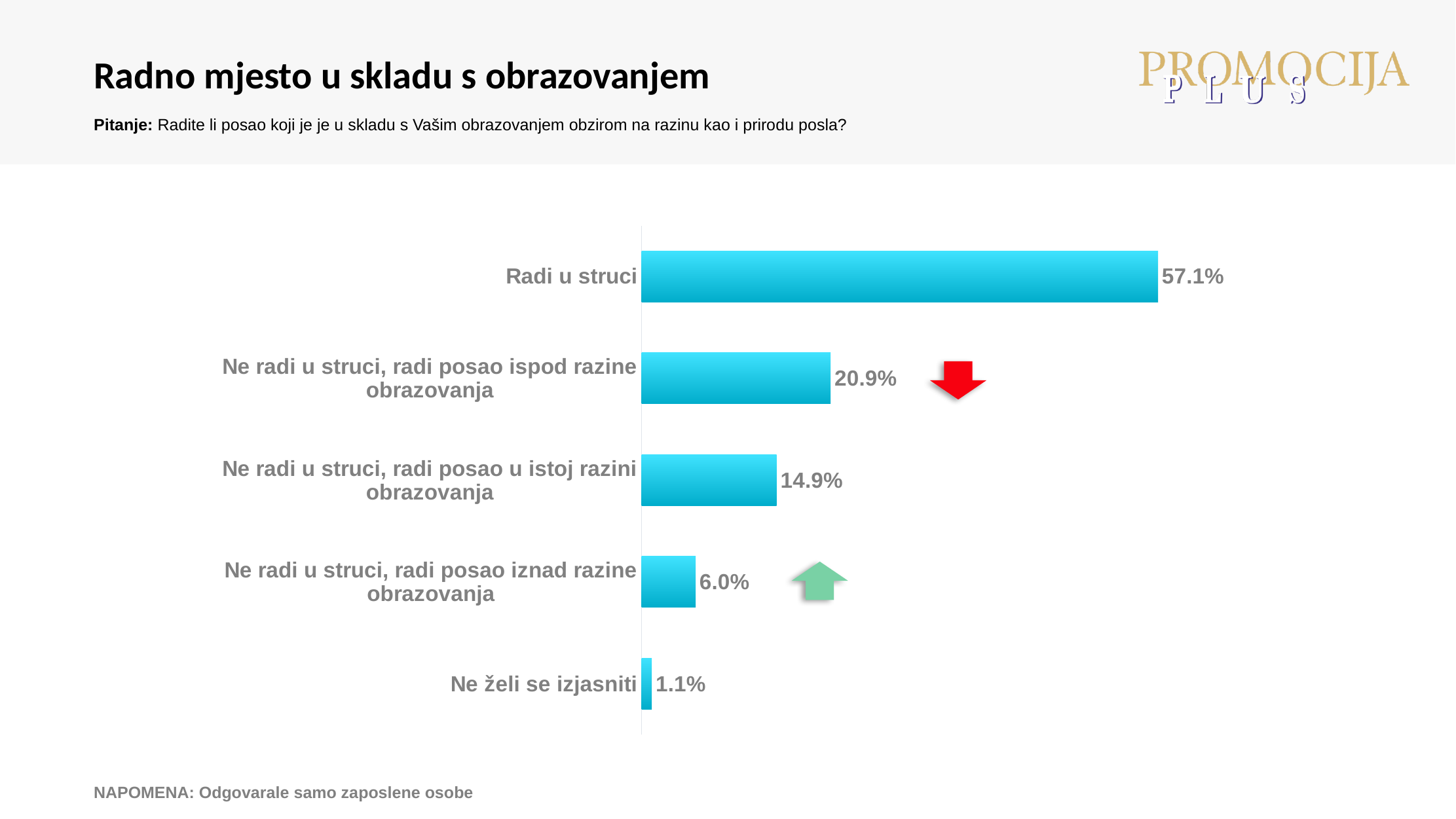
What is the value for "Ne želi se izjasniti"? 1.1% What is the value for "Radi u struci"? 57.1% Which category has the lowest value? Ne želi se izjasniti What is the value for "Ne radi u struci, radi posao iznad razine obrazovanja"? 6.0% What is the value for "Ne radi u struci, radi posao ispod razine obrazovanja"? 20.9% How many categories are shown in the chart? 5 Which is larger: "Ne radi u struci, radi posao u istoj razini obrazovanja" or "Ne radi u struci, radi posao iznad razine obrazovanja"? Ne radi u struci, radi posao u istoj razini obrazovanja What is the title of the slide? Radno mjesto u skladu s obrazovanjem What is the value for "Ne radi u struci, radi posao u istoj razini obrazovanja"? 14.9% What is the difference between "Radi u struci" and "Ne radi u struci, radi posao ispod razine obrazovanja"? 36.2% What kind of chart is shown on the slide? Bar chart Which category has the highest value? Radi u struci